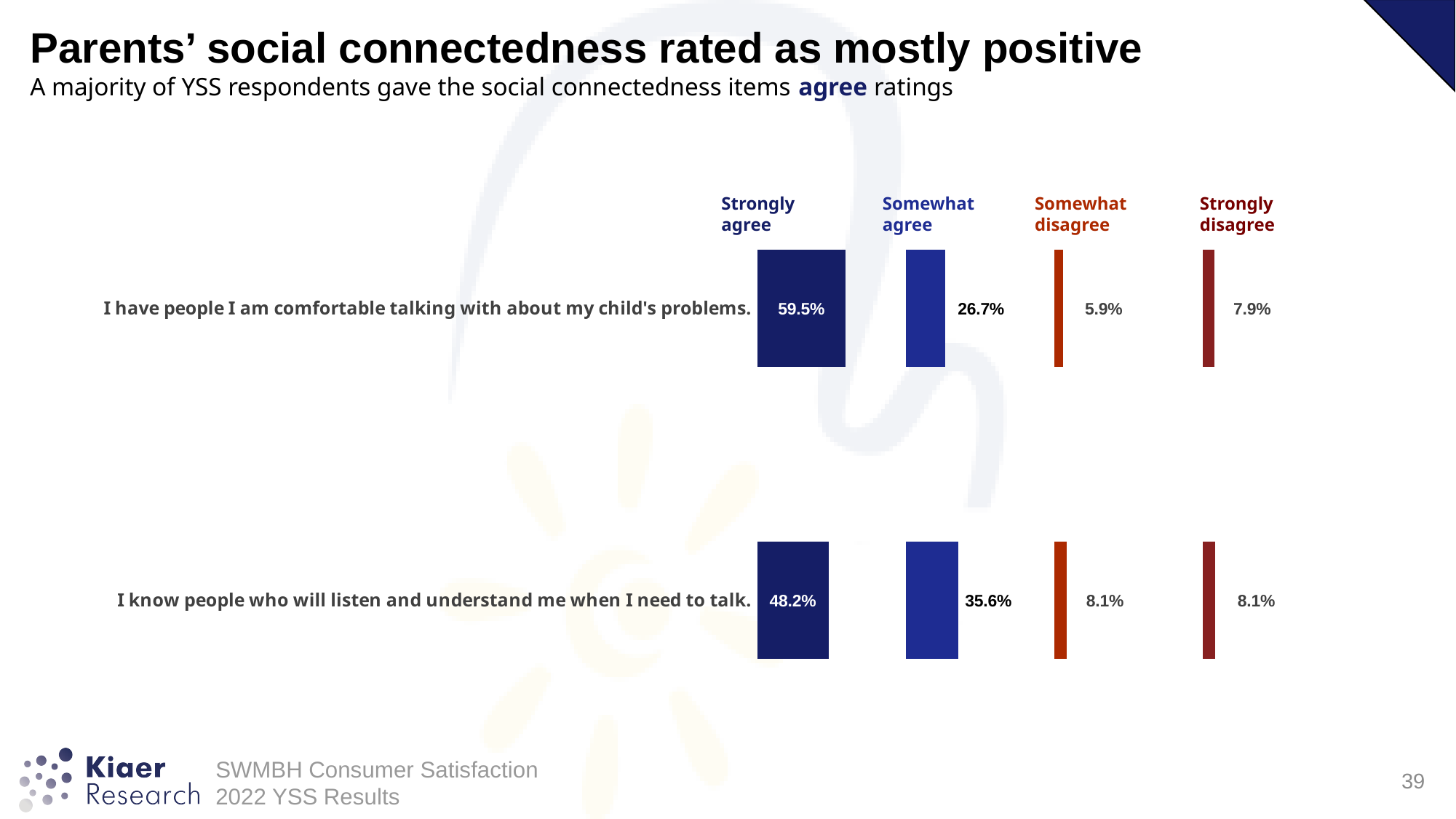
Which response category has the highest percentage for "I have people I am comfortable talking with about my child's problems"? Strongly agree Which item has a higher somewhat agree percentage? I know people who will listen and understand me when I need to talk. What percentage of respondents strongly disagreed with "I know people who will listen and understand me when I need to talk"? 8.1% How many response categories are shown across the top of the chart? 4 What type of chart is shown on the slide? Bar chart Which response category has the lowest percentage for "I have people I am comfortable talking with about my child's problems"? Somewhat disagree What percentage of respondents somewhat agreed with "I know people who will listen and understand me when I need to talk"? 35.6% How many survey items are shown in the chart? 2 What is the difference between the somewhat agree and somewhat disagree percentages for "I know people who will listen and understand me when I need to talk"? 27.5% What is the difference between the strongly agree percentages for the two items? 11.3% What percentage of respondents somewhat disagreed with "I have people I am comfortable talking with about my child's problems"? 5.9% What percentage of respondents strongly agreed with "I have people I am comfortable talking with about my child's problems"? 59.5%